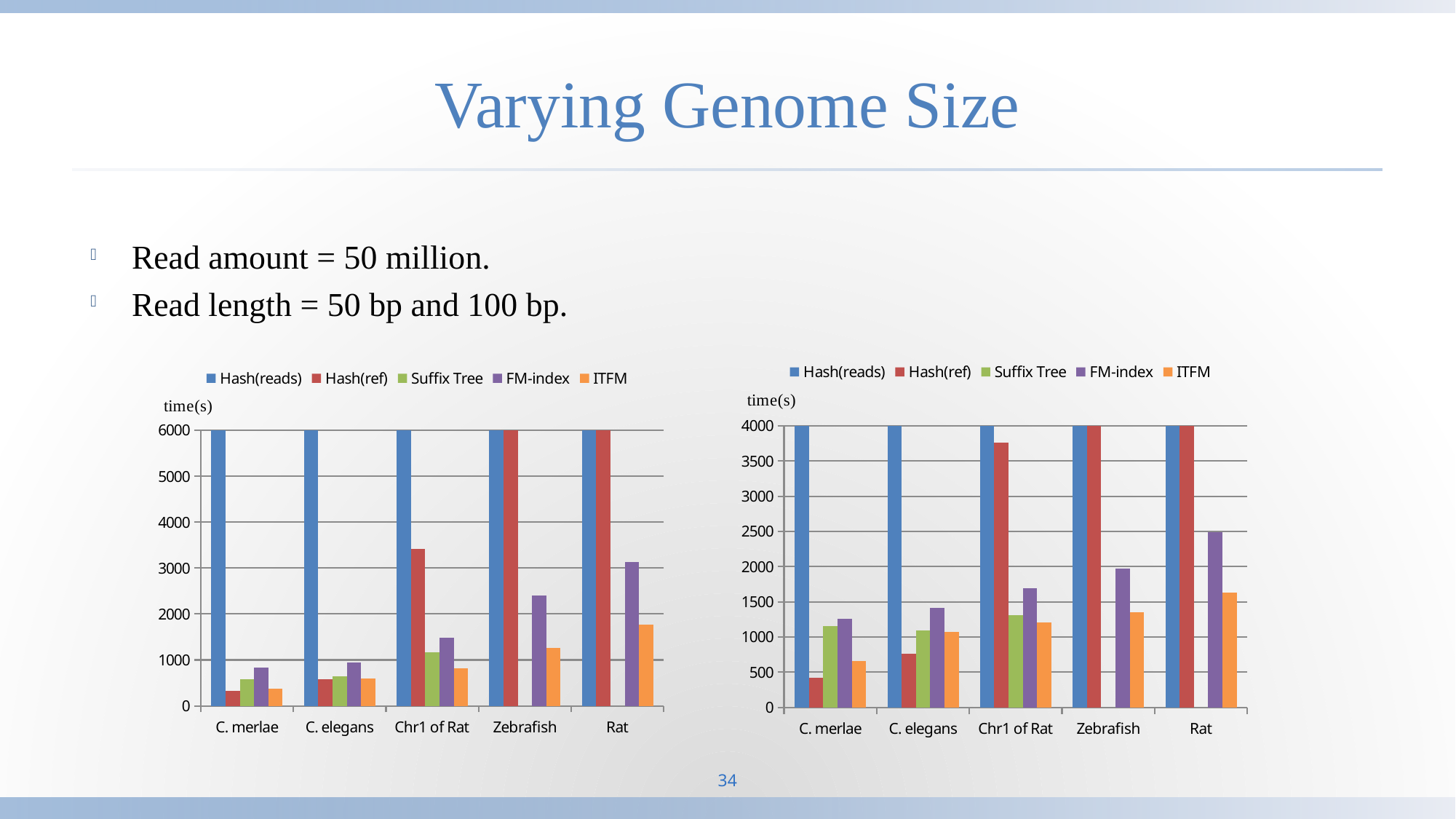
In the right chart, which category has the highest FM-index value? Rat In the left chart, which category has the lowest ITFM value? C. merlae In the right chart, is the FM-index value for Rat greater or less than 2000? greater In the left chart, which is larger: the FM-index value for Rat or the FM-index value for Zebrafish? Rat In the left chart, is the ITFM value for Rat greater or less than 2000? less In the right chart, which is larger for C. elegans: Hash(ref) or Suffix Tree? Suffix Tree What kind of chart is the left chart? bar chart In the left chart, is the Hash(ref) value for Chr1 of Rat greater or less than 3000? greater How many series does the legend of the right chart list? 5 How many categories are shown on the x axis of the left chart? 5 In the right chart, do the ITFM values rise or fall from C. merlae to Rat along the x axis? rise